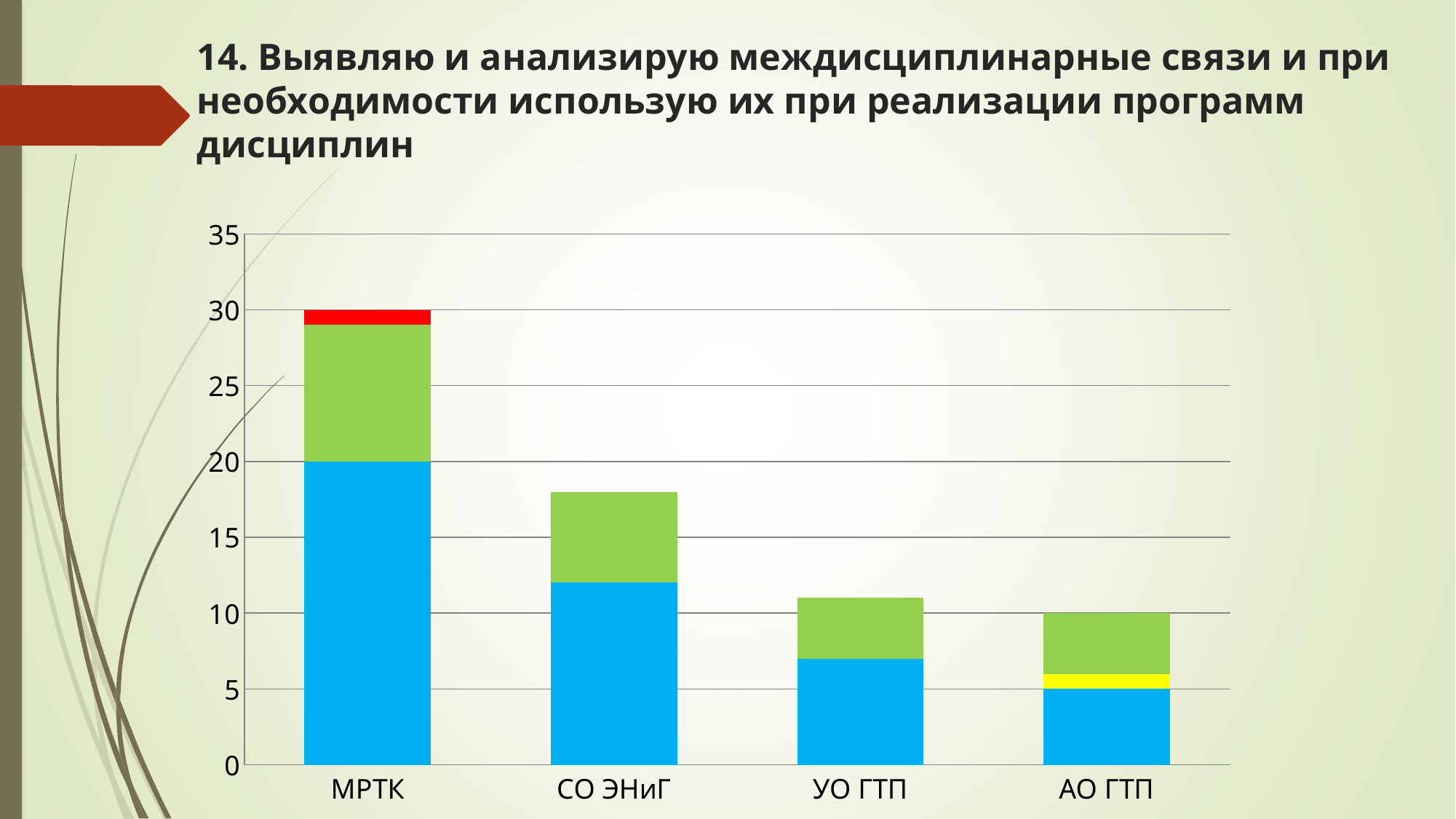
Which category has the shortest stacked bar? АО ГТП What is the total height of the stacked bar for АО ГТП? 10 Is the total value for УО ГТП greater or less than 10? greater Which stacked bar is taller, СО ЭНиГ or УО ГТП? СО ЭНиГ What is the value of the blue (bottom) segment for МРТК? 20 What is the total height of the stacked bar for МРТК? 30 What is the value of the blue (bottom) segment for АО ГТП? 5 How many categories are shown on the x axis of the chart? 4 Which category has the tallest stacked bar? МРТК Which category's bar includes a red segment at the top? МРТК Is the total value for СО ЭНиГ greater or less than 20? less What kind of chart is shown on the slide? stacked bar chart